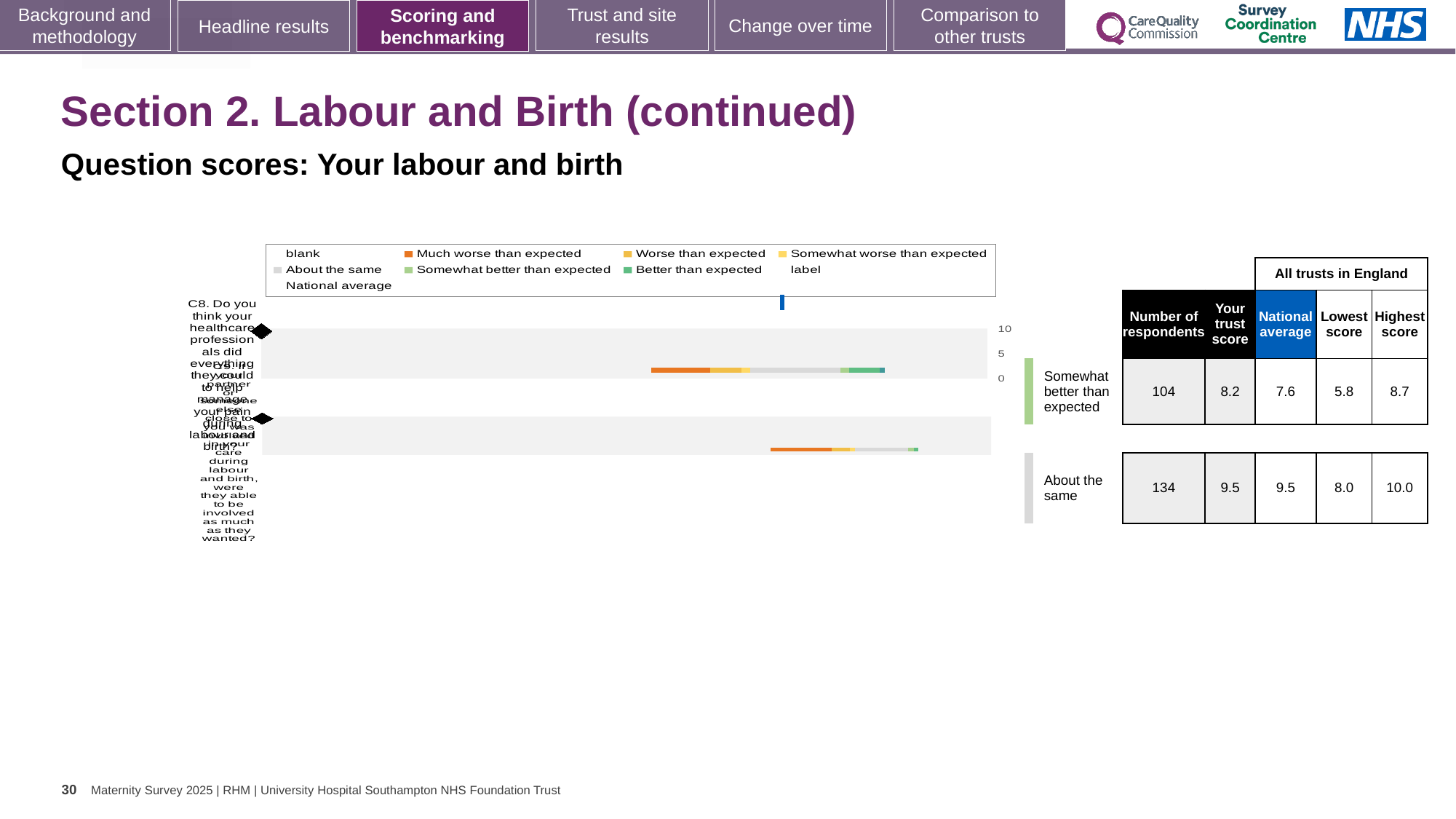
Which legend entry is shown in orange? Much worse than expected In the table beside the chart, what is the difference between the trust score and the national average for the row rated 'Somewhat better than expected'? 0.6 In the table beside the chart, which is larger for the row rated 'Somewhat better than expected': the trust score or the national average? trust score How many question rows (bars) are plotted in the chart? 2 In the table beside the chart, what is the lowest score across all trusts in England for the row rated 'Somewhat better than expected'? 5.8 What kind of chart is shown on the slide? bar chart In the table beside the chart, what is the number of respondents for the row rated 'Somewhat better than expected'? 104 What is the highest tick value shown on the chart's score axis? 10 In the table beside the chart, what is the trust score for the row rated 'Somewhat better than expected'? 8.2 In the table beside the chart, what is the number of respondents for the row rated 'About the same'? 134 In the table beside the chart, what is the national average for the row rated 'Somewhat better than expected'? 7.6 In the table beside the chart, what is the highest score across all trusts in England for the row rated 'About the same'? 10.0